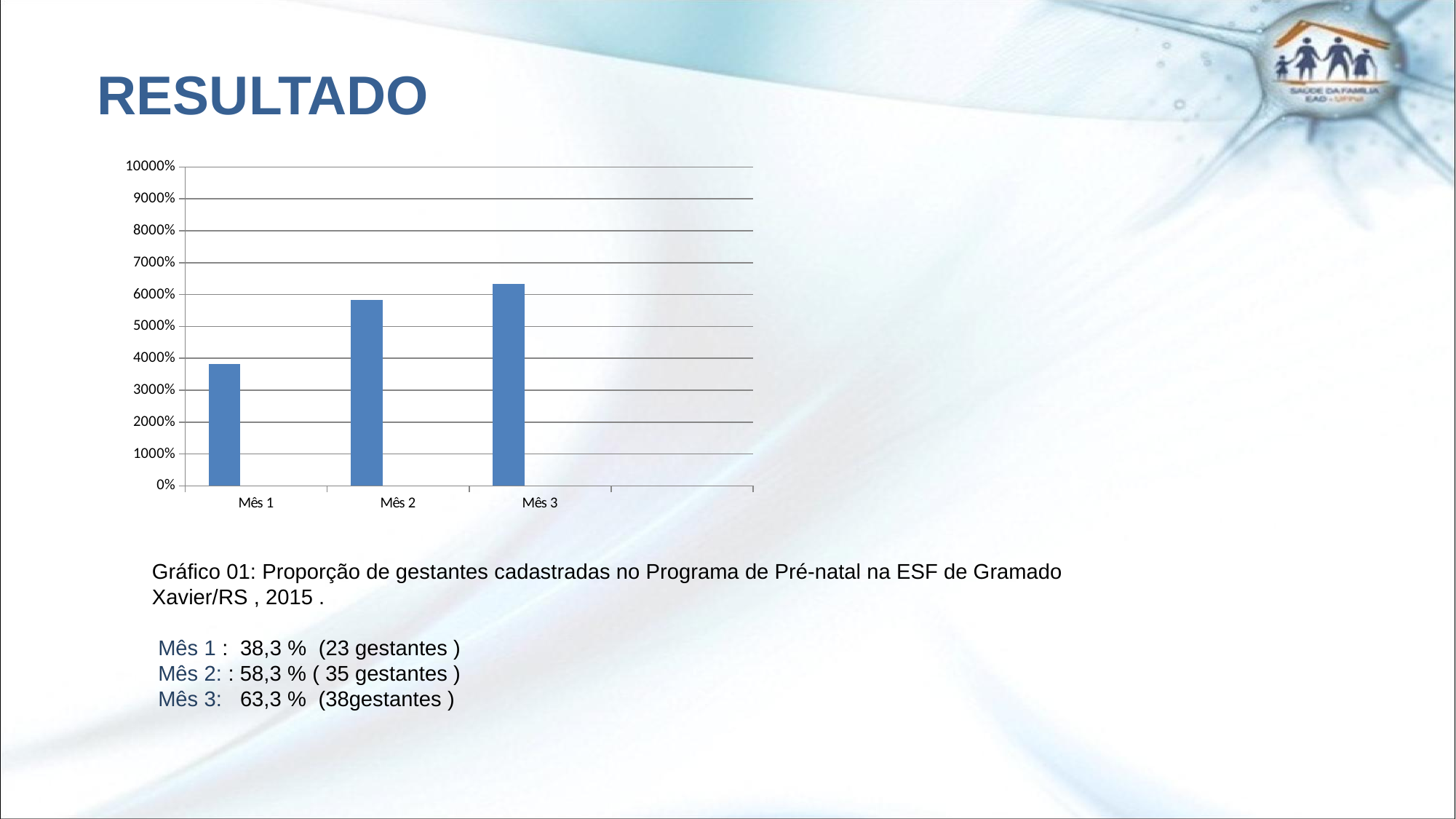
How many categories (months) are plotted in the chart? 3 Do the bar values rise or fall from Mês 1 to Mês 3? rise Which month has the lowest bar in the chart? Mês 1 Which month has the highest bar in the chart? Mês 3 Is the bar for Mês 2 greater or less than 5000% on the axis? greater According to the text below the chart, what proportion is given for Mês 1? 38,3 % Which is larger, the bar for Mês 2 or the bar for Mês 3? Mês 3 Is the bar for Mês 1 greater or less than 4000% on the axis? less Is the bar for Mês 3 greater or less than 7000% on the axis? less What is the number of the graph given in the caption below the chart? Gráfico 01 According to the text below the chart, how many gestantes correspond to Mês 3? 38 What kind of chart is shown on the slide? bar chart